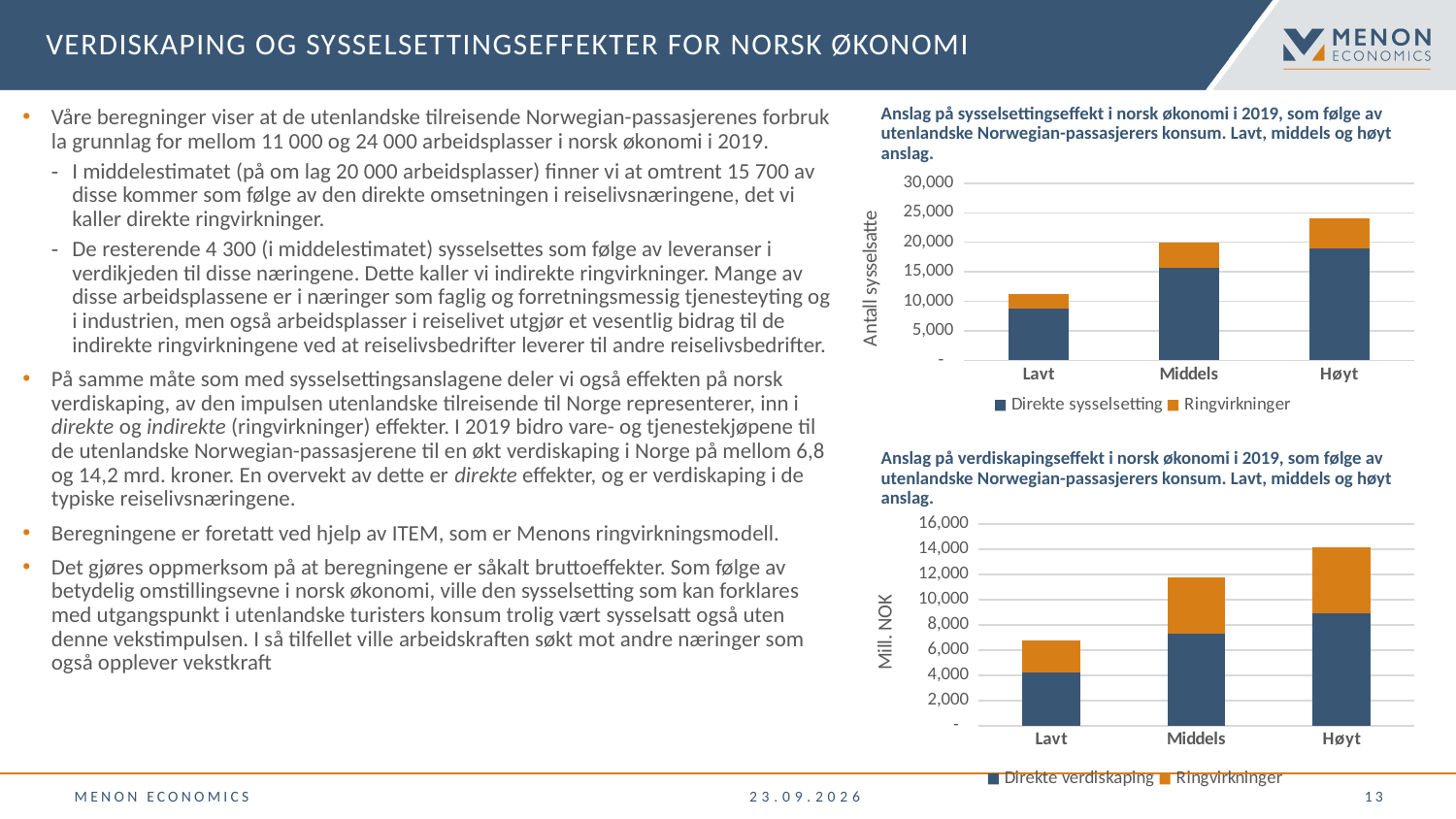
In the bottom chart (verdiskapingseffekt), is the total for Lavt greater or less than 8,000? less What is the y-axis label of the bottom chart (verdiskapingseffekt)? Mill. NOK In the top chart (sysselsettingseffekt), is the total for Høyt greater or less than 25,000? less In the top chart (sysselsettingseffekt), which category has the lowest total bar? Lavt How many categories are shown on the x axis of the top chart (sysselsettingseffekt)? 3 In the top chart (sysselsettingseffekt), which category has the highest total bar? Høyt In the top chart (sysselsettingseffekt), is the total for Middels greater or less than 15,000? greater What are the two legend entries of the bottom chart (verdiskapingseffekt)? Direkte verdiskaping and Ringvirkninger What kind of chart is the top chart on the slide (sysselsettingseffekt)? Stacked bar chart How many series does the legend of the top chart (sysselsettingseffekt) list? 2 In the top chart (sysselsettingseffekt), do the total bars rise or fall from Lavt to Høyt? rise In the bottom chart (verdiskapingseffekt), which is larger: the Direkte verdiskaping segment for Høyt or for Lavt? Høyt